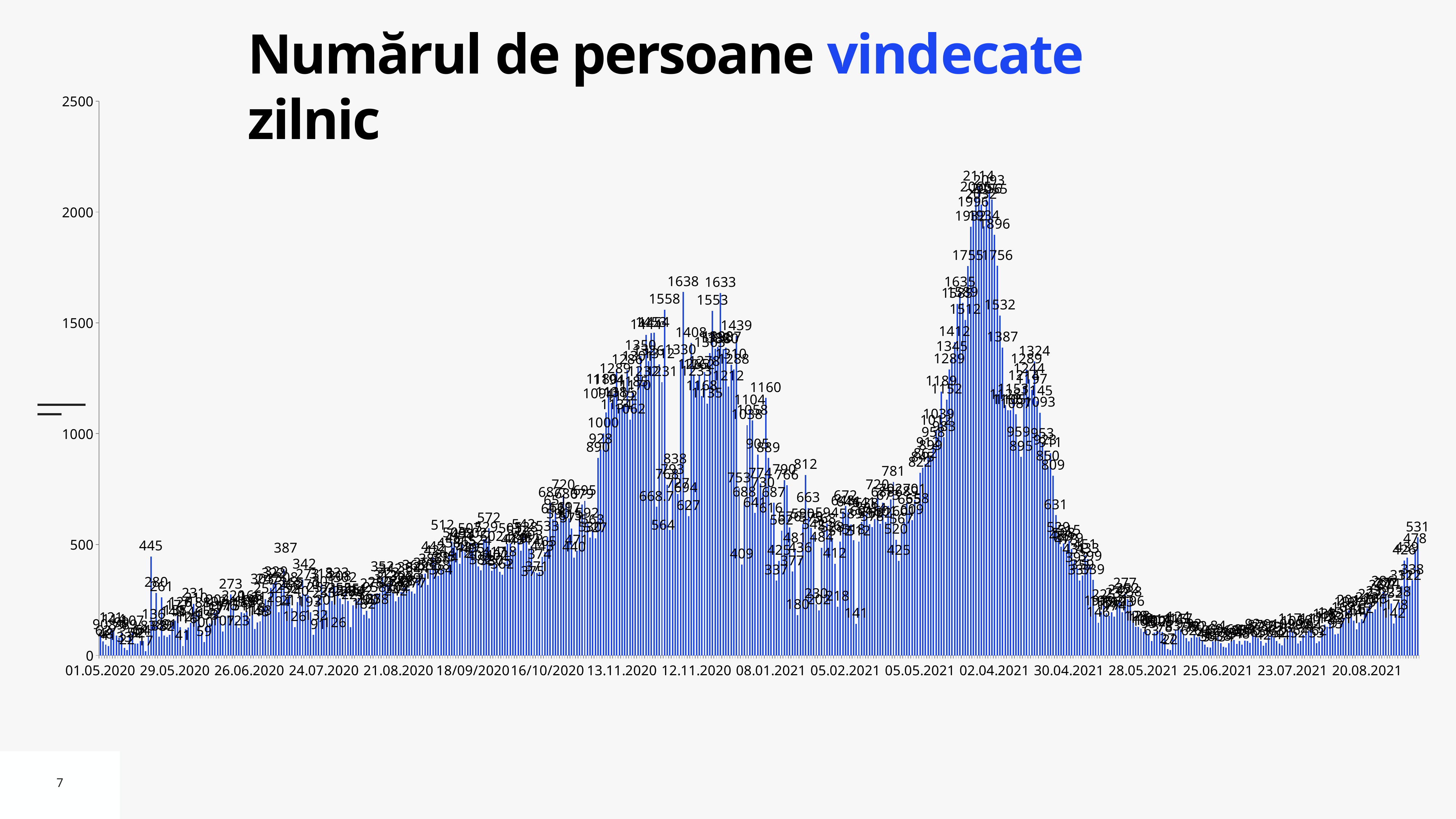
What is the difference between the highest labeled value (2114) and the last bar's value (531)? 1583 Which is larger: the bar labeled 445 or the bar labeled 387? 445 Do the values rise or fall along the x axis from 02.04.2021 to 25.06.2021? fall What is the first date label on the x axis? 01.05.2020 What is the highest data label value shown on the chart? 2114 What is the value of the last (rightmost) bar on the chart? 531 What is the title of the chart? Numărul de persoane vindecate zilnic What kind of chart is shown on the slide? bar chart Are the bar values around 25.06.2021 greater or less than 500? less Is the value of the tallest bar, near 02.04.2021, greater or less than 2000? greater What is the value of the tall isolated bar labeled just after 29.05.2020? 445 What is the maximum value shown on the y axis? 2500